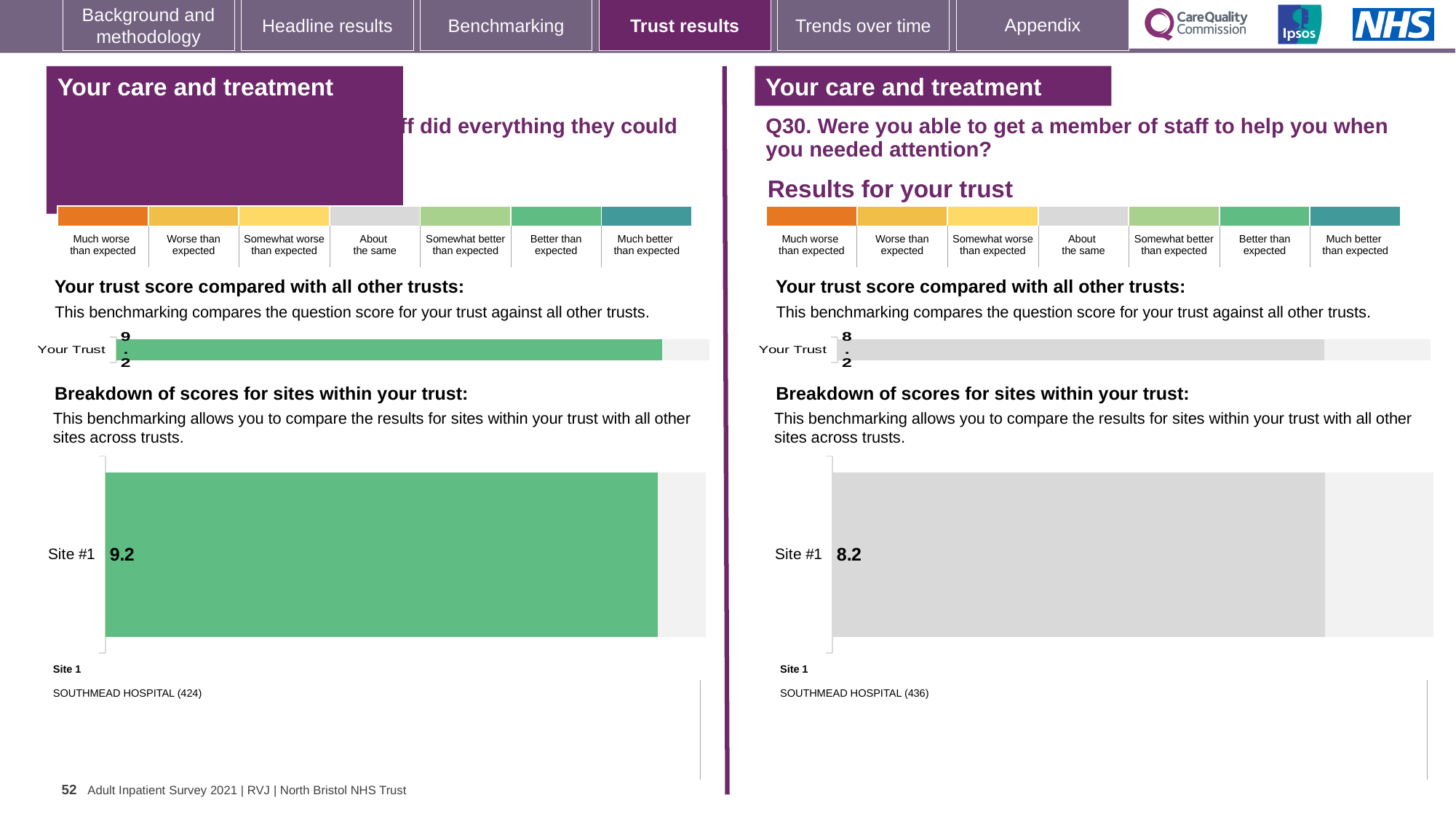
On the left half of the slide, which benchmark category does the green colour of the Your Trust bar correspond to in the key? Better than expected On the right half of the slide (Q30), what is the score shown for Your Trust in the 'Your trust score compared with all other trusts' chart? 8.2 On the left half of the slide, what score is shown for Site #1 in the 'Breakdown of scores for sites within your trust' chart? 9.2 Which is larger: the Site #1 score on the left half of the slide or the Site #1 score on the right half (Q30)? Left half (9.2) What kind of chart is used to show the Site #1 score on the left half of the slide? Bar chart On the right half of the slide (Q30), which benchmark category does the grey colour of the Site #1 bar correspond to in the key? About the same On the left half of the slide, what is the score shown for Your Trust in the 'Your trust score compared with all other trusts' chart? 9.2 Which site name is listed under Site 1 on the right half of the slide (Q30)? SOUTHMEAD HOSPITAL (436) How many sites are shown in the 'Breakdown of scores for sites within your trust' chart on the right half of the slide (Q30)? 1 On the right half of the slide (Q30), what score is shown for Site #1 in the 'Breakdown of scores for sites within your trust' chart? 8.2 Which site name is listed under Site 1 on the left half of the slide? SOUTHMEAD HOSPITAL (424) What is the difference between the Your Trust score on the left half of the slide and the Your Trust score on the right half (Q30)? 1.0